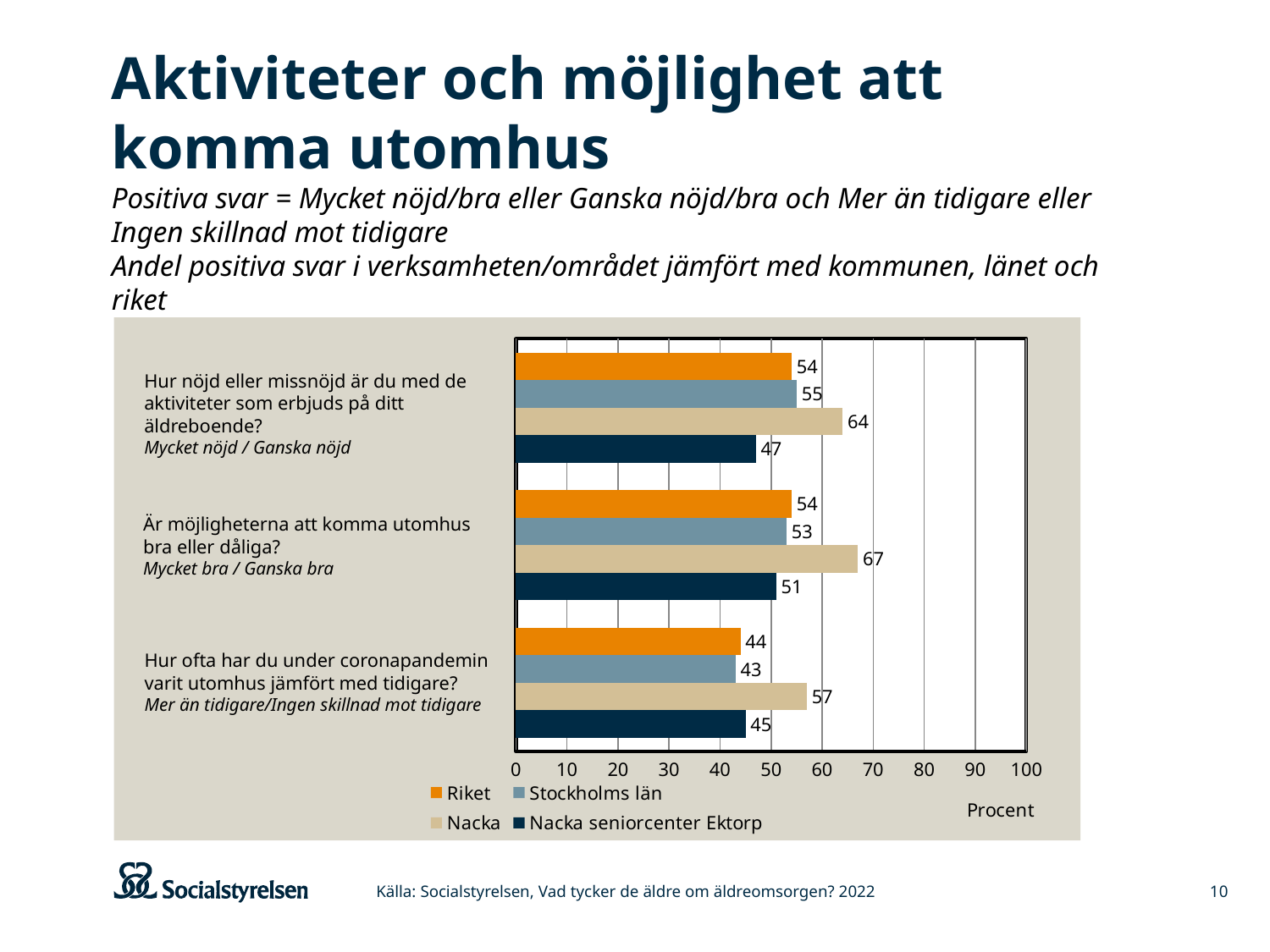
How many series does the legend list? 4 What unit is shown on the horizontal axis of the chart? Procent What is the value for Stockholms län on the question about how often respondents have been outdoors during the corona pandemic compared to before? 43 What is the difference between the Nacka value and the Nacka seniorcenter Ektorp value on the question about satisfaction with activities offered at the elderly home? 17 What is the value for Riket on the question about opportunities to get outdoors (Är möjligheterna att komma utomhus bra eller dåliga?)? 54 What is the value for Nacka on the question about satisfaction with activities offered at the elderly home (Hur nöjd eller missnöjd är du med de aktiviteter...)? 64 On the question about being outdoors during the corona pandemic, which is larger: the value for Nacka or the value for Riket? Nacka Which series has the highest value on the question about opportunities to get outdoors (Är möjligheterna att komma utomhus bra eller dåliga?)? Nacka How many question categories are shown on the chart? 3 Which series has the lowest value on the question about satisfaction with activities offered at the elderly home? Nacka seniorcenter Ektorp What is the value for Nacka seniorcenter Ektorp on the question about opportunities to get outdoors (Är möjligheterna att komma utomhus bra eller dåliga?)? 51 What kind of chart is shown on the slide? Bar chart